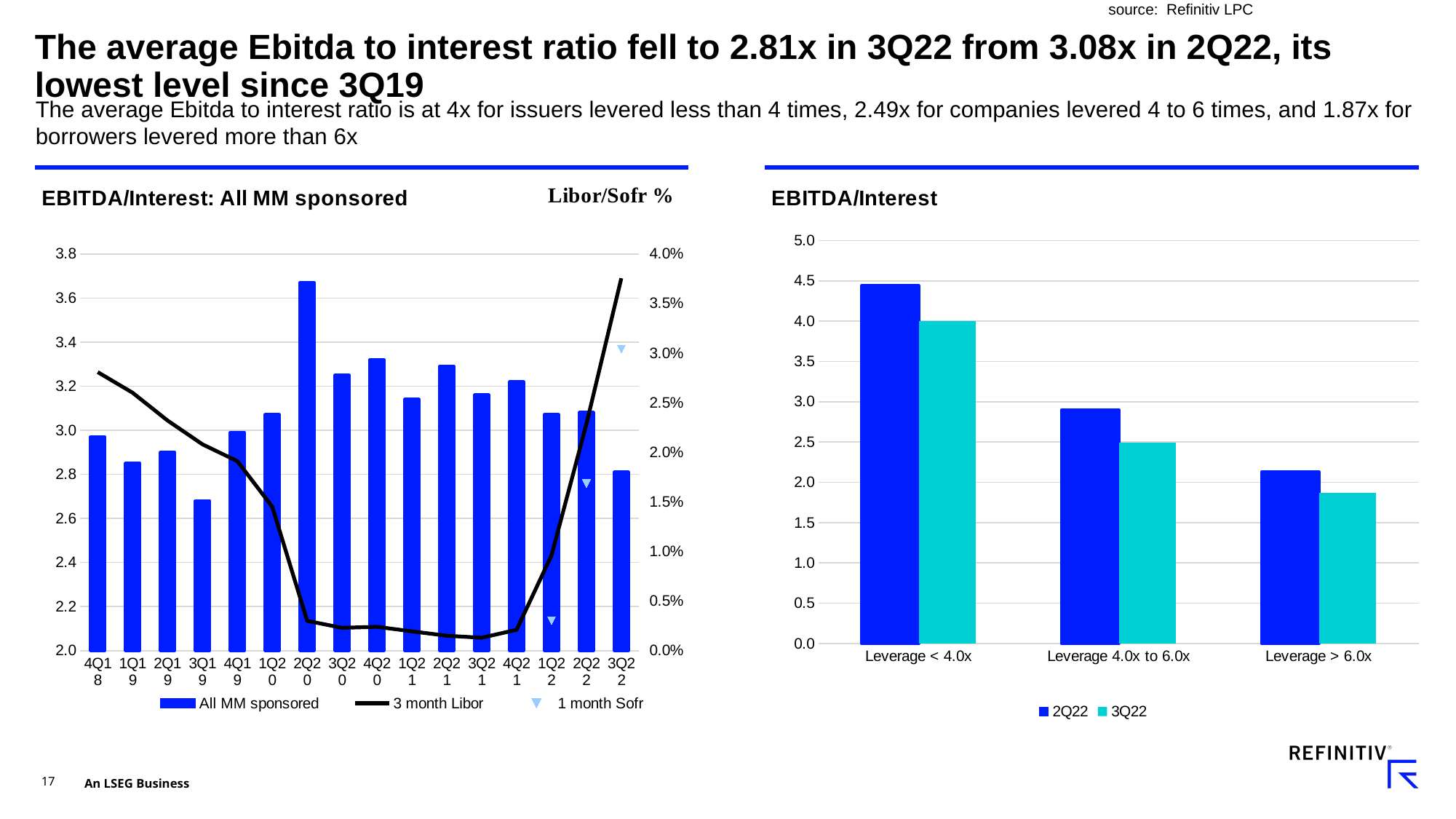
How many series does the legend of the 'EBITDA/Interest: All MM sponsored' chart list? 3 On the right-hand 'EBITDA/Interest' chart, what is the 3Q22 value for Leverage < 4.0x? 4.0 On the right-hand 'EBITDA/Interest' chart, which is larger for Leverage 4.0x to 6.0x: the 2Q22 value or the 3Q22 value? 2Q22 On the 'EBITDA/Interest: All MM sponsored' chart, is the 3 month Libor value at 3Q22 greater or less than 3.5%? greater How many quarters (bars) are plotted on the 'EBITDA/Interest: All MM sponsored' chart? 16 How many leverage categories are shown on the right-hand 'EBITDA/Interest' chart? 3 On the right-hand 'EBITDA/Interest' chart, is the 3Q22 value for Leverage > 6.0x greater or less than 2.0? less On the 'EBITDA/Interest: All MM sponsored' chart, which quarter has the lowest All MM sponsored bar? 3Q19 On the 'EBITDA/Interest: All MM sponsored' chart, which quarter has the highest All MM sponsored bar? 2Q20 How many series does the legend of the right-hand 'EBITDA/Interest' chart list? 2 On the right-hand 'EBITDA/Interest' chart, which leverage category has the highest 2Q22 value? Leverage < 4.0x What kind of chart is the 'EBITDA/Interest' chart on the right of the slide? bar chart